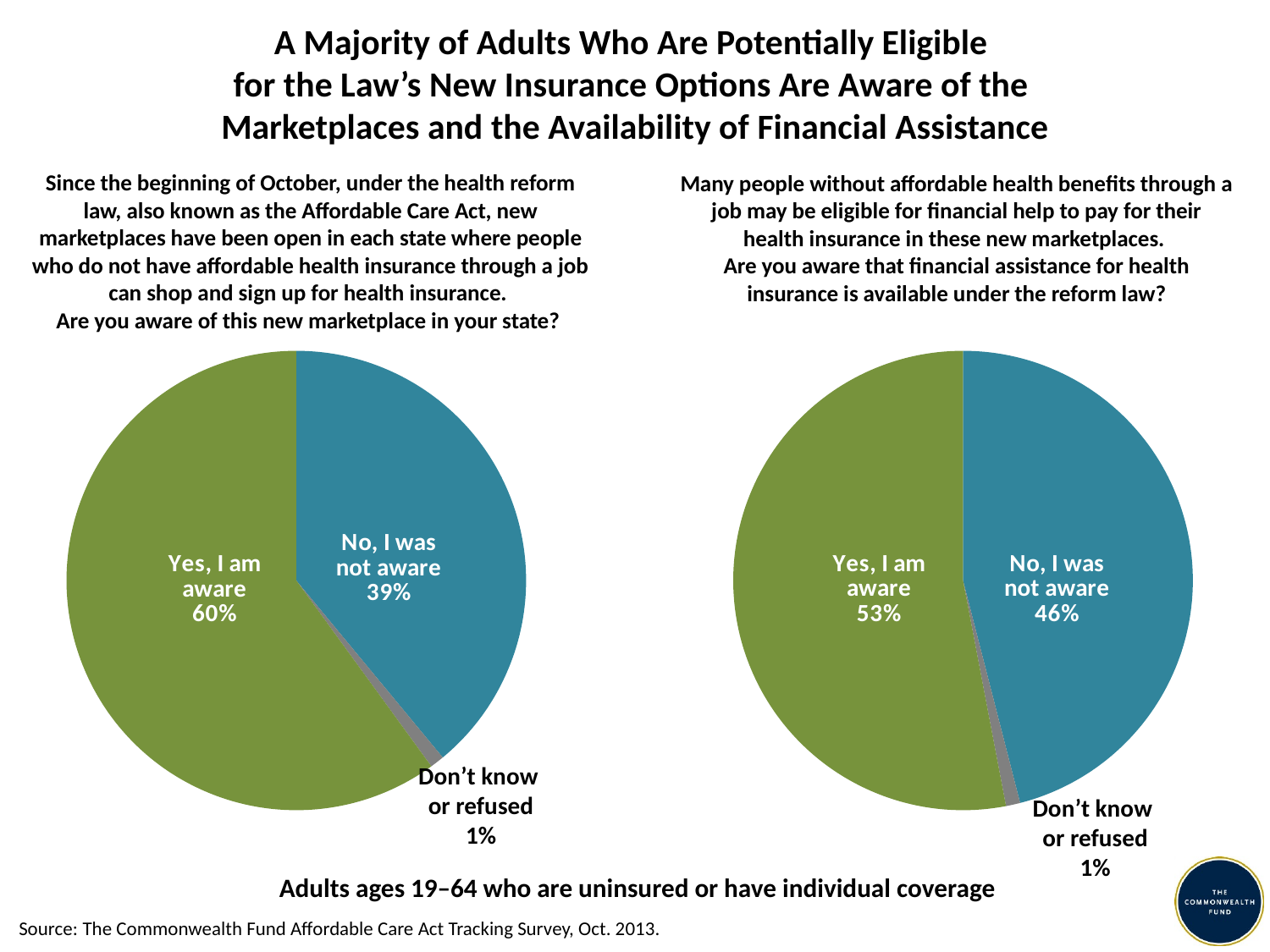
Which chart shows a larger share for "Yes, I am aware": the left pie chart (new marketplace) or the right pie chart (financial assistance)? The left pie chart (new marketplace) In the right pie chart (awareness of financial assistance), which response has the smallest share? Don't know or refused In the left pie chart (awareness of the new marketplace), what is the difference in percentage points between "Yes, I am aware" and "No, I was not aware"? 21 percentage points In the right pie chart (awareness of financial assistance), what is the difference in percentage points between "Yes, I am aware" and "No, I was not aware"? 7 percentage points How many slices does the left pie chart (awareness of the new marketplace) have? 3 In the left pie chart (awareness of the new marketplace), what share of adults answered "Yes, I am aware"? 60% In the left pie chart (awareness of the new marketplace), which response has the largest share? Yes, I am aware In the right pie chart (awareness of financial assistance), what share of adults answered "Yes, I am aware"? 53% In the right pie chart (awareness of financial assistance), what share of adults answered "No, I was not aware"? 46% In the right pie chart (awareness of financial assistance), what share answered "Don't know or refused"? 1% In the left pie chart (awareness of the new marketplace), what share of adults answered "No, I was not aware"? 39% What type of chart is used on this slide? Pie chart